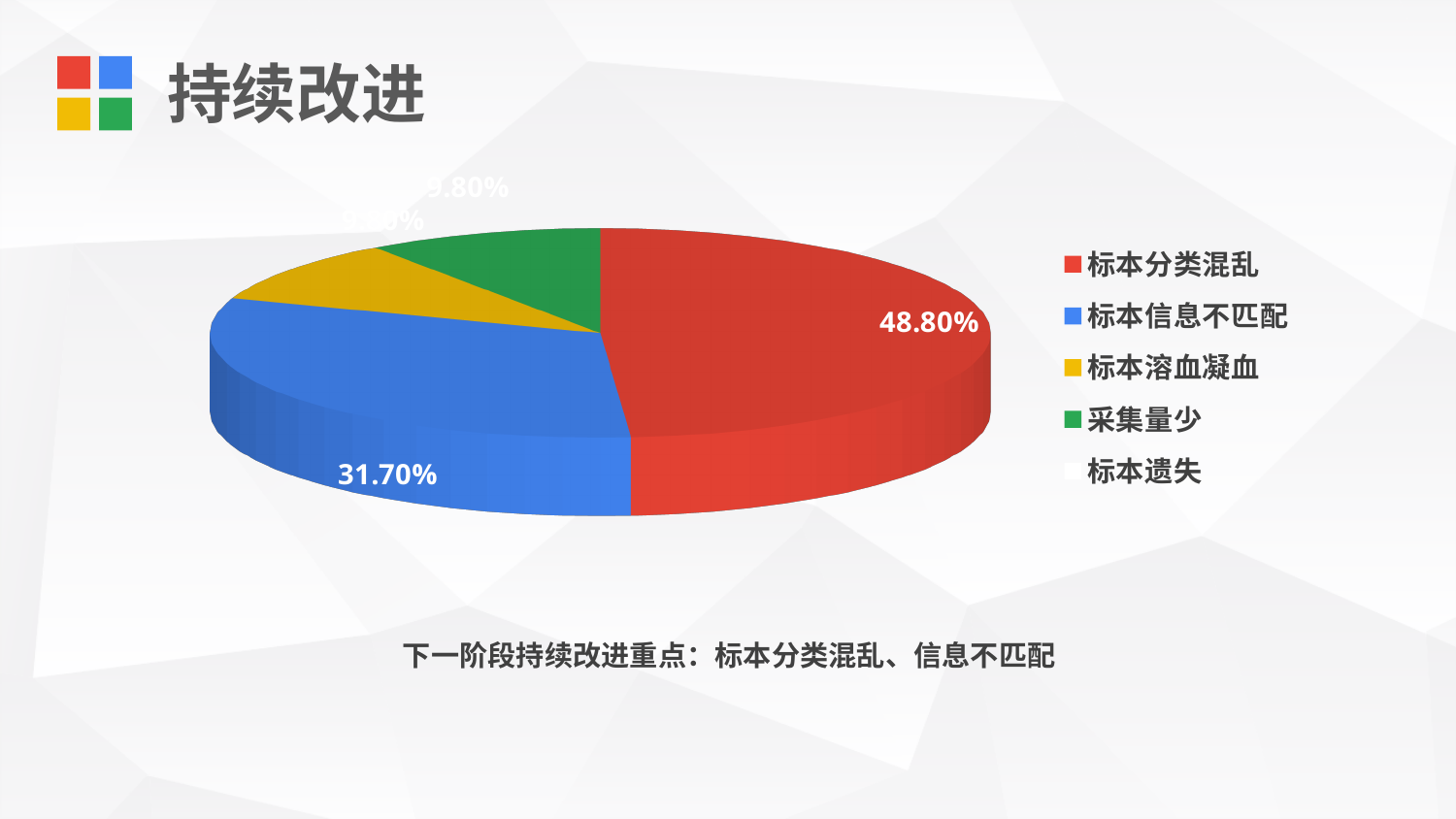
Which category has the largest slice in the pie chart? 标本分类混乱 How many entries does the legend of the pie chart list? 5 Which is larger, the share for 标本分类混乱 or the share for 标本信息不匹配? 标本分类混乱 What percentage does the 标本分类混乱 slice represent in the pie chart? 48.80% What colour is the 标本分类混乱 slice in the pie chart? Red What is the title of the slide containing the pie chart? 持续改进 What kind of chart is shown on the slide? Pie chart What percentage does the 标本信息不匹配 slice represent in the pie chart? 31.70% What percentage does the 采集量少 slice represent in the pie chart? 9.80% What is the difference between the shares for 标本分类混乱 and 标本信息不匹配? 17.10% Which is larger, the share for 标本信息不匹配 or the share for 采集量少? 标本信息不匹配